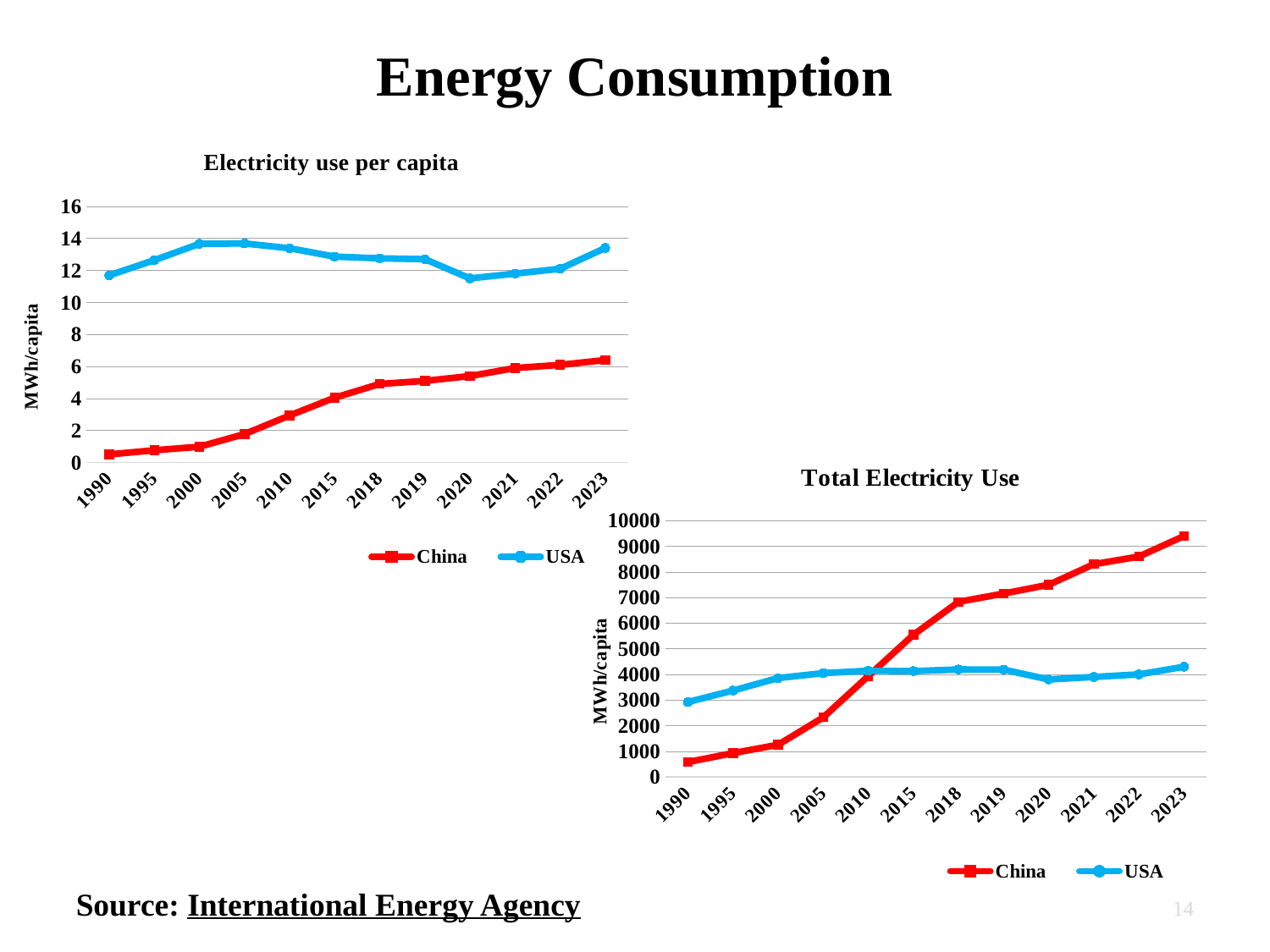
In the "Electricity use per capita" chart, does the China line rise or fall from 1990 to 2023? rise How many series does the legend of the "Total Electricity Use" chart list? 2 In the "Electricity use per capita" chart, is the value for China in 2023 greater or less than 6? greater What kind of chart is the "Electricity use per capita" chart? line chart In the "Electricity use per capita" chart, which series has the higher value in 2023, China or USA? USA What is the y-axis label of the "Total Electricity Use" chart? MWh/capita In the "Total Electricity Use" chart, in which year does China reach its highest value? 2023 In the "Electricity use per capita" chart, is the value for USA in 1990 greater or less than 10? greater In the "Total Electricity Use" chart, is the value for USA in 2023 greater or less than 5000? less In the "Total Electricity Use" chart, which series has the higher value in 1990, China or USA? USA How many years are plotted along the x axis of the "Electricity use per capita" chart? 12